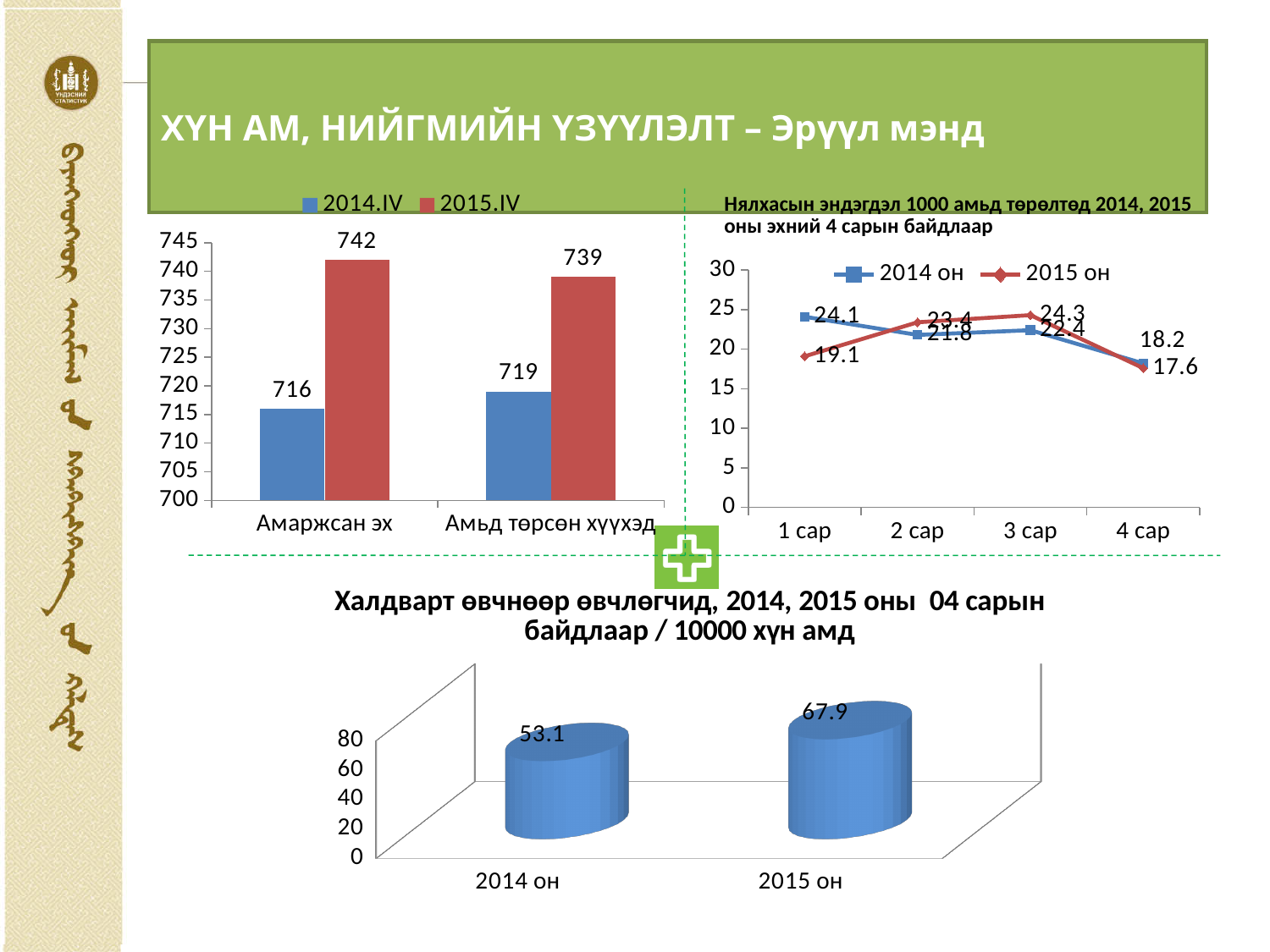
In the chart titled 'Нялхасын эндэгдэл 1000 амьд төрөлтөд 2014, 2015 оны эхний 4 сарын байдлаар', what is the 2014 он value for 1 сар? 24.1 In the top-left bar chart, what is the difference between the 2015.IV and 2014.IV values for Амаржсан эх? 26 In the chart titled 'Халдварт өвчнөөр өвчлөгчид, 2014, 2015 оны 04 сарын байдлаар / 10000 хүн амд', what is the difference between the 2015 он and 2014 он values? 14.8 In the top-left bar chart, what is the 2015.IV value for Амаржсан эх? 742 In the top-left bar chart, how many series does the legend list? 2 In the chart titled 'Нялхасын эндэгдэл 1000 амьд төрөлтөд 2014, 2015 оны эхний 4 сарын байдлаар', what kind of chart is it? line chart In the top-left bar chart, which is larger for Амьд төрсөн хүүхэд: 2014.IV or 2015.IV? 2015.IV In the chart titled 'Нялхасын эндэгдэл 1000 амьд төрөлтөд 2014, 2015 оны эхний 4 сарын байдлаар', how many months are shown on the x axis? 4 In the chart titled 'Халдварт өвчнөөр өвчлөгчид, 2014, 2015 оны 04 сарын байдлаар / 10000 хүн амд', what is the value for 2015 он? 67.9 In the chart titled 'Нялхасын эндэгдэл 1000 амьд төрөлтөд 2014, 2015 оны эхний 4 сарын байдлаар', what is the 2015 он value for 3 сар? 24.3 In the top-left bar chart, what is the 2014.IV value for Амьд төрсөн хүүхэд? 719 In the chart titled 'Нялхасын эндэгдэл 1000 амьд төрөлтөд 2014, 2015 оны эхний 4 сарын байдлаар', which month has the lowest 2015 он value? 4 сар